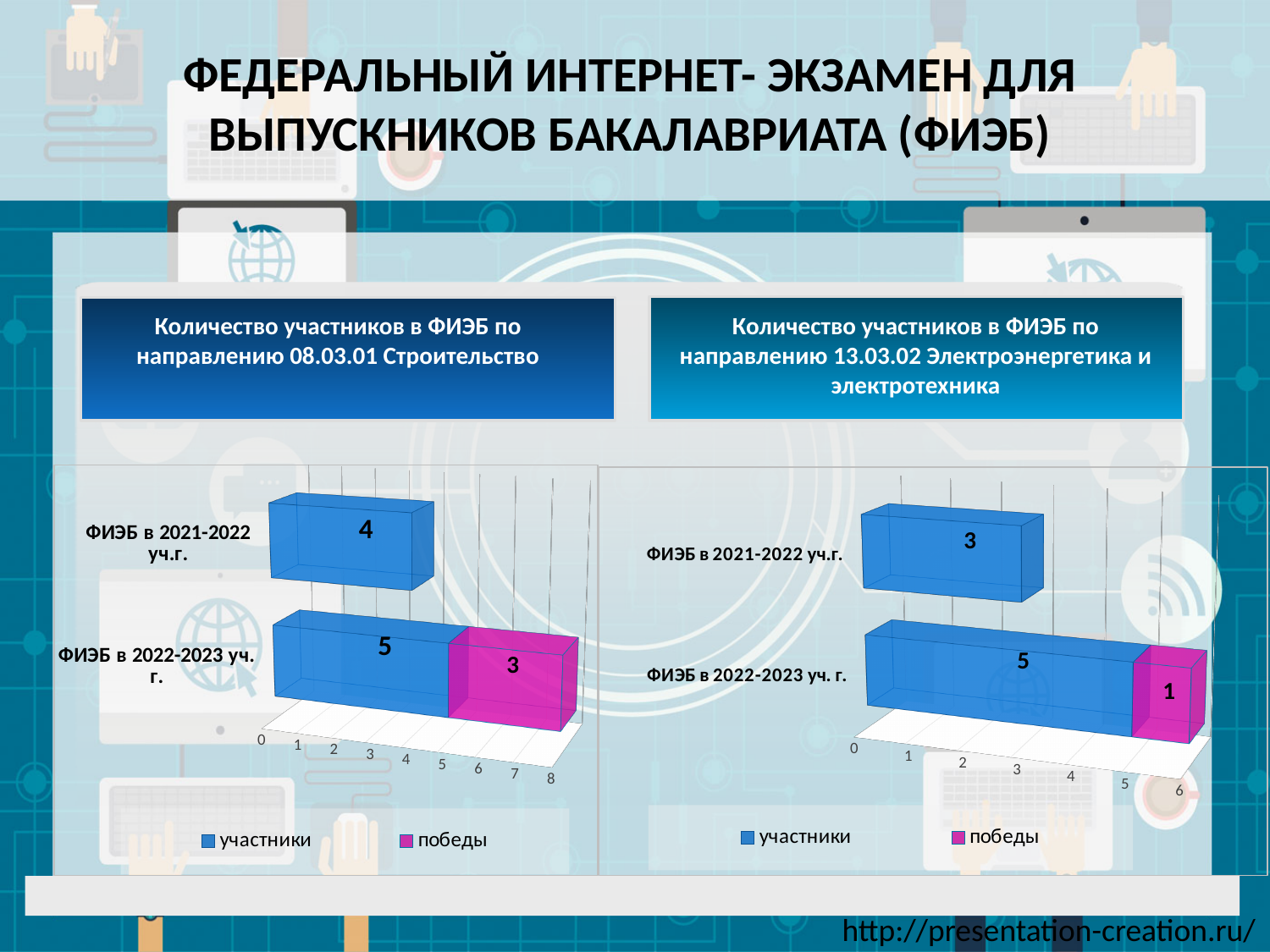
In the chart titled 'Количество участников в ФИЭБ по направлению 13.03.02 Электроэнергетика и электротехника', what is the value for победы in ФИЭБ в 2022-2023 уч. г.? 1 In the chart titled 'Количество участников в ФИЭБ по направлению 08.03.01 Строительство', which year has the higher value for участники? ФИЭБ в 2022-2023 уч. г. In the chart titled 'Количество участников в ФИЭБ по направлению 13.03.02 Электроэнергетика и электротехника', what is the value for участники in ФИЭБ в 2021-2022 уч.г.? 3 In the chart titled 'Количество участников в ФИЭБ по направлению 13.03.02 Электроэнергетика и электротехника', what is the total of the stacked bar for ФИЭБ в 2022-2023 уч. г.? 6 In the chart titled 'Количество участников в ФИЭБ по направлению 08.03.01 Строительство', what is the value for участники in ФИЭБ в 2021-2022 уч.г.? 4 How many series does the legend list in the chart titled 'Количество участников в ФИЭБ по направлению 08.03.01 Строительство'? 2 What kind of chart is the chart titled 'Количество участников в ФИЭБ по направлению 13.03.02 Электроэнергетика и электротехника'? Bar chart In the chart titled 'Количество участников в ФИЭБ по направлению 08.03.01 Строительство', what is the value for победы in ФИЭБ в 2022-2023 уч. г.? 3 In the chart titled 'Количество участников в ФИЭБ по направлению 08.03.01 Строительство', what is the value for участники in ФИЭБ в 2022-2023 уч. г.? 5 In the chart titled 'Количество участников в ФИЭБ по направлению 08.03.01 Строительство', what colour represents the победы series? Magenta In the chart titled 'Количество участников в ФИЭБ по направлению 13.03.02 Электроэнергетика и электротехника', what is the difference between участники in ФИЭБ в 2022-2023 уч. г. and участники in ФИЭБ в 2021-2022 уч.г.? 2 In the chart titled 'Количество участников в ФИЭБ по направлению 08.03.01 Строительство', what is the total of the stacked bar for ФИЭБ в 2022-2023 уч. г.? 8